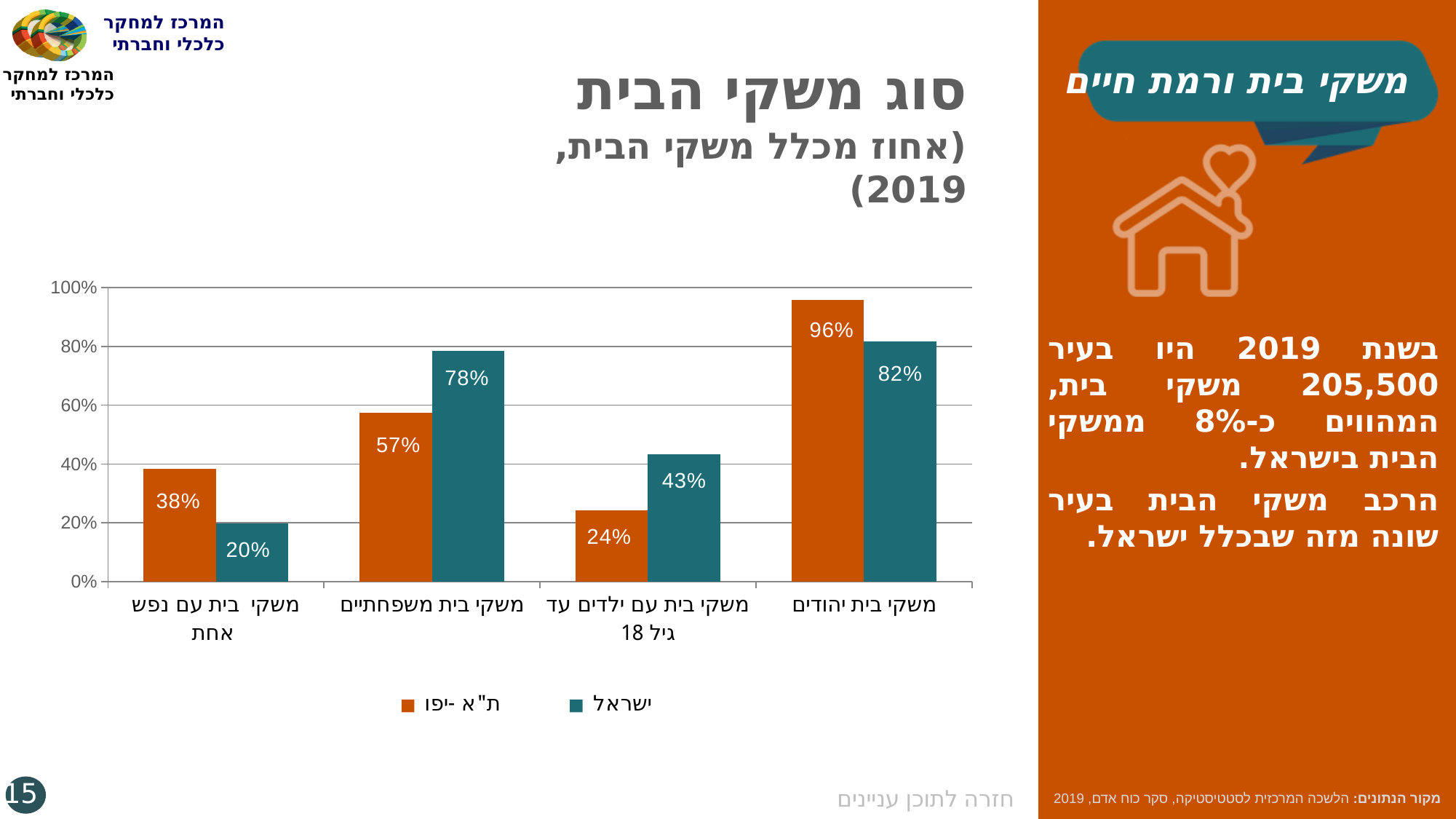
How many series does the legend list? 2 Which colour represents the series ישראל in the chart? teal What is the value for ישראל in the category משקי בית משפחתיים? 78% What is the difference between the ישראל and ת"א -יפו values in the category משקי בית משפחתיים? 21% What kind of chart is shown on the slide? bar chart How many categories are shown on the x axis of the chart? 4 Which category has the lowest value for ישראל? משקי בית עם נפש אחת What is the value for ת"א -יפו in the category משקי בית עם ילדים עד גיל 18? 24% In the category משקי בית עם ילדים עד גיל 18, which series has the larger value, ת"א -יפו or ישראל? ישראל What is the value for ת"א -יפו in the category משקי בית עם נפש אחת? 38% Which category has the highest value for ת"א -יפו? משקי בית יהודים What is the value for ישראל in the category משקי בית יהודים? 82%